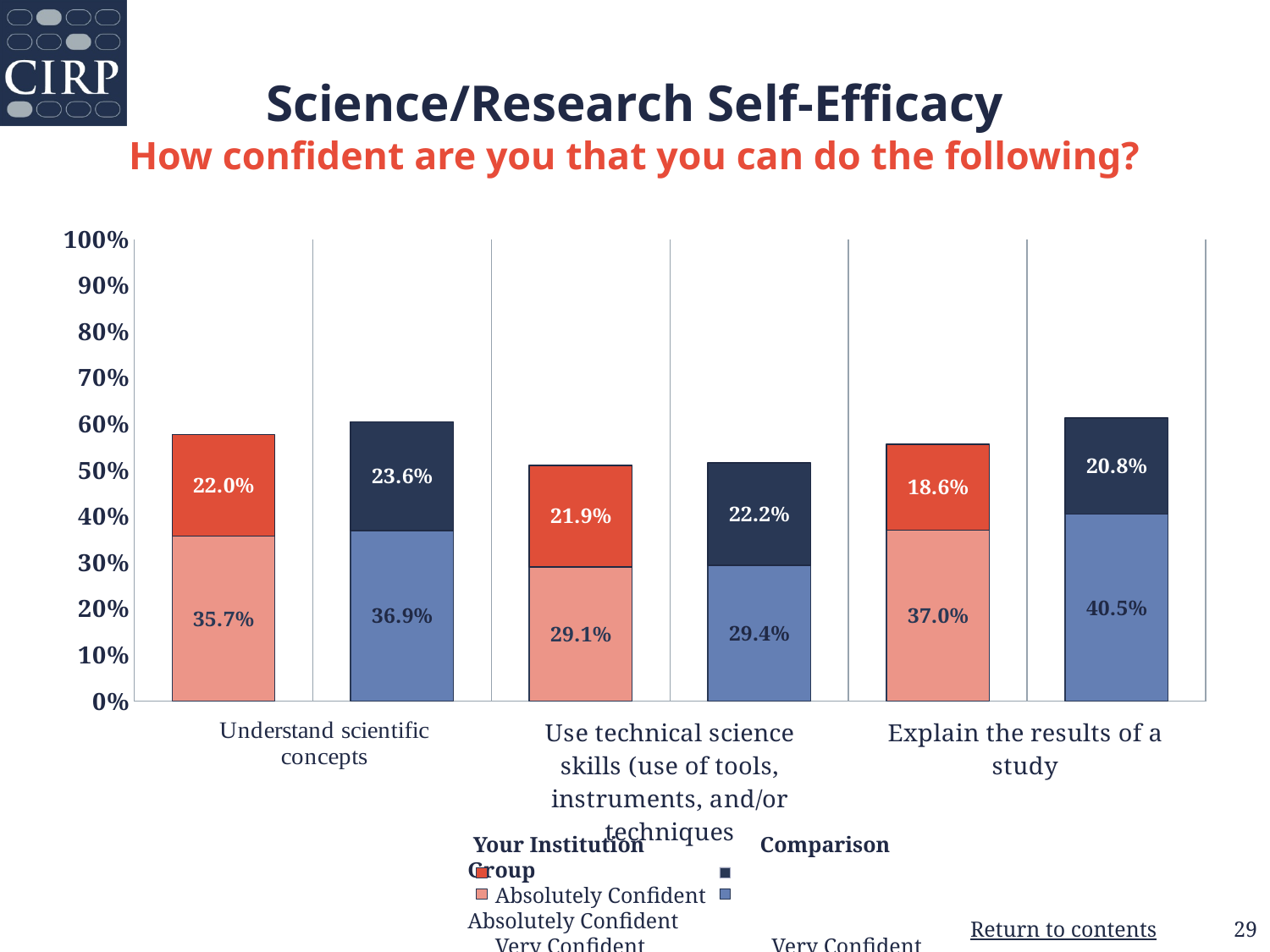
What is the value of the bottom (light red) segment of the Your Institution bar for 'Understand scientific concepts'? 35.7% What is the difference between the bottom segments of the Comparison Group and Your Institution bars for 'Explain the results of a study'? 3.5% What type of chart is shown on the slide? Stacked bar chart Which is larger: the top segment of the Your Institution bar or the top segment of the Comparison Group bar for 'Understand scientific concepts'? Comparison Group (23.6%) What is the value of the bottom (light blue) segment of the Comparison Group bar for 'Use technical science skills'? 29.4% What is the total of the Comparison Group stacked bar for 'Explain the results of a study'? 61.3% Among the Your Institution bars, which category has the lowest bottom (light red) segment value? Use technical science skills What is the value of the top (dark navy) segment of the Comparison Group bar for 'Explain the results of a study'? 20.8% How many categories are shown along the x axis? 3 What is the value of the top (red) segment of the Your Institution bar for 'Explain the results of a study'? 18.6% What is the total of the Your Institution stacked bar for 'Understand scientific concepts'? 57.7% Is the total of the Your Institution bar for 'Use technical science skills' greater or less than 60%? less